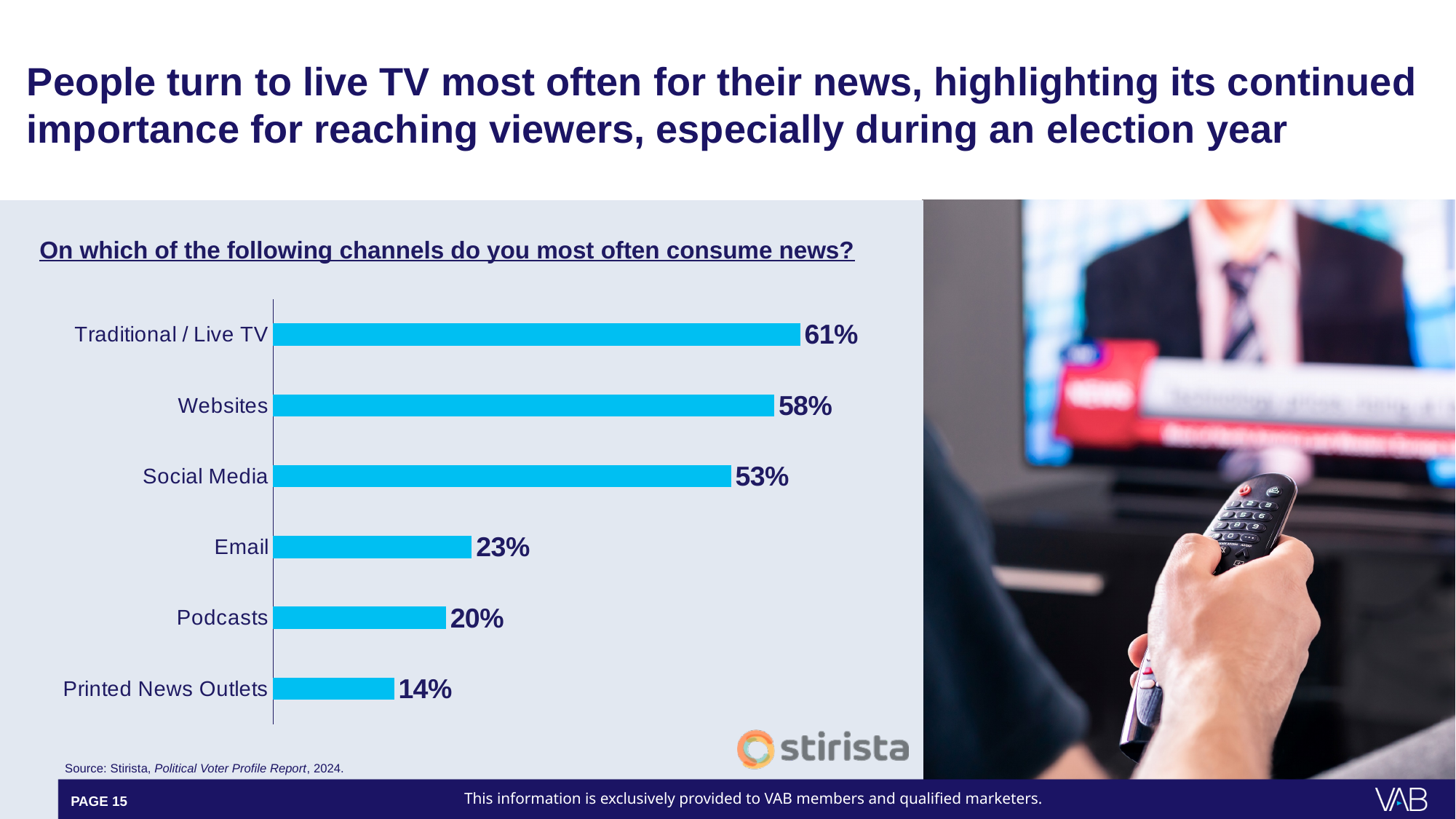
Which channel has the highest percentage? Traditional / Live TV What survey question is the chart based on? On which of the following channels do you most often consume news? What is the difference between the values for Traditional / Live TV and Social Media? 8% How many channels are shown in the chart? 6 What percentage is shown for Podcasts? 20% Which has a larger value, Social Media or Email? Social Media What percentage of respondents most often consume news on Traditional / Live TV? 61% What is the source cited for the chart? Stirista, Political Voter Profile Report, 2024. Which channel has the lowest percentage? Printed News Outlets What is the difference between the values for Email and Printed News Outlets? 9% What is the value shown for Websites? 58% What kind of chart is shown on the slide? Bar chart